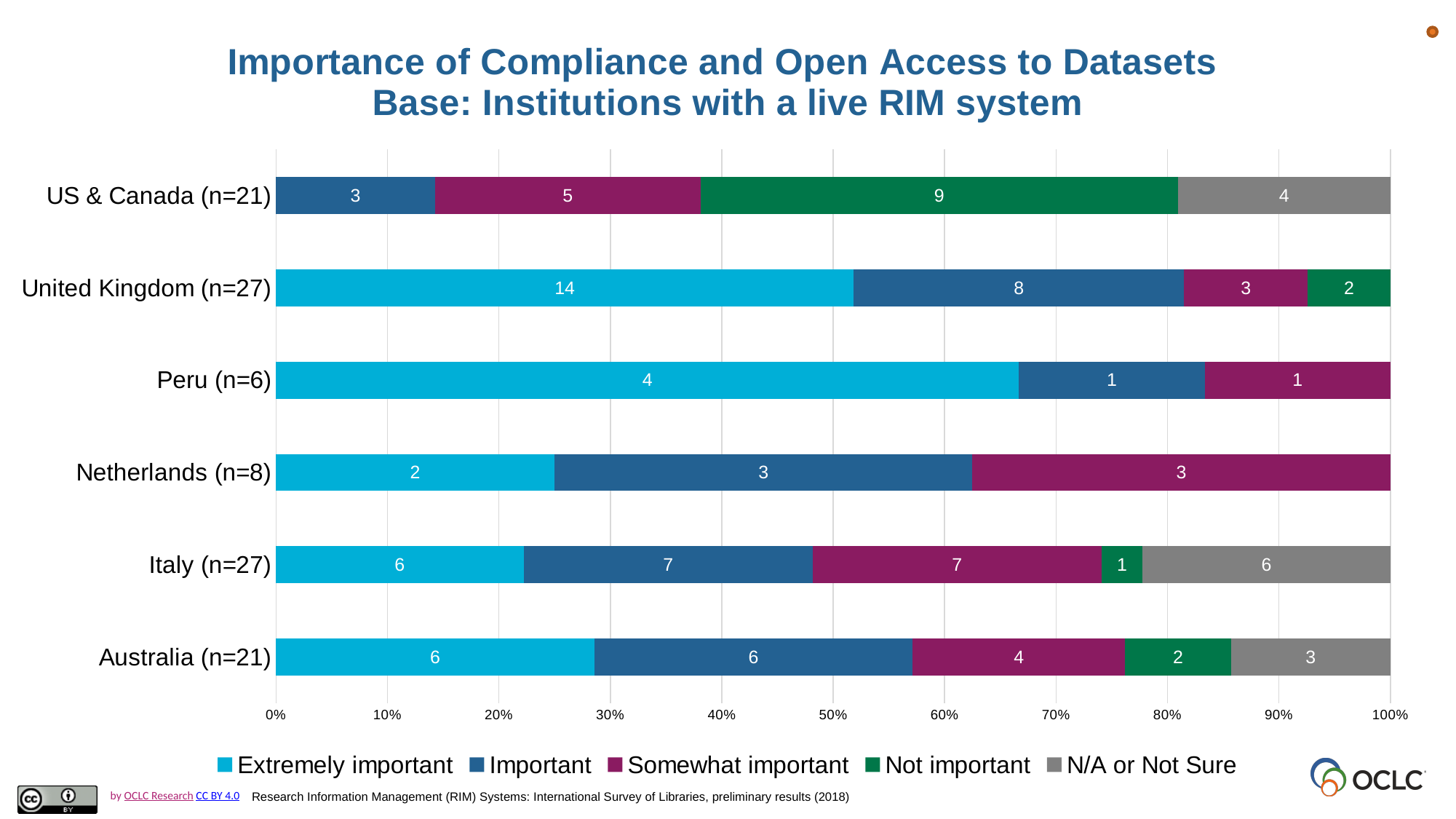
What is the total of the segments in the Italy bar? 27 Which legend entry is shown in grey? N/A or Not Sure Which region has the lowest count for Important? Peru (n=6) How many Italian institutions answered N/A or Not Sure? 6 How many series does the legend list? 5 Which region has the highest count for Extremely important? United Kingdom (n=27) What kind of chart is shown on the slide? Stacked bar chart What is the difference between the Extremely important counts for the United Kingdom and Australia? 8 How many regions are shown on the chart? 6 Which is larger: the Somewhat important count for US & Canada or for Australia? US & Canada How many institutions in the United Kingdom rated compliance and open access to datasets as Extremely important? 14 What is the value for Not important in the US & Canada bar? 9